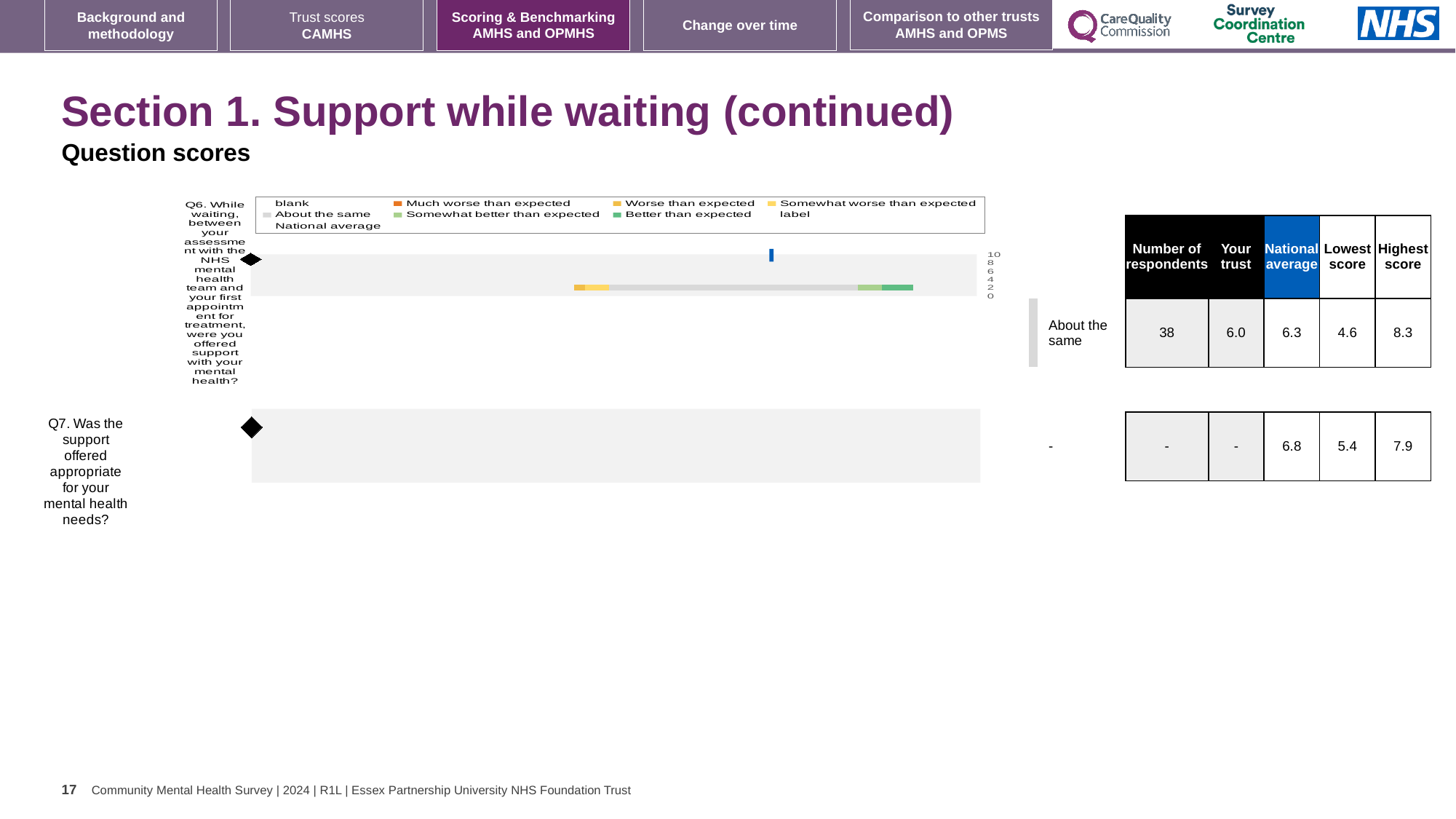
What is the difference between the highest and lowest scores for Q6? 3.7 What is the lowest score for Q6? 4.6 How many respondents answered Q6? 38 How many entries does the legend of the Q6 chart list? 9 What is the national average score for Q6? 6.3 Which benchmark category is the trust's Q6 score placed in? About the same What kind of chart is used to show the Q6 score? bar chart What is the highest score for Q6? 8.3 What is the national average score for Q7? 6.8 What is the trust's score for Q6? 6.0 For Q6, which is larger: the trust's score or the national average? National average What is the highest value shown on the Q6 chart's axis? 10